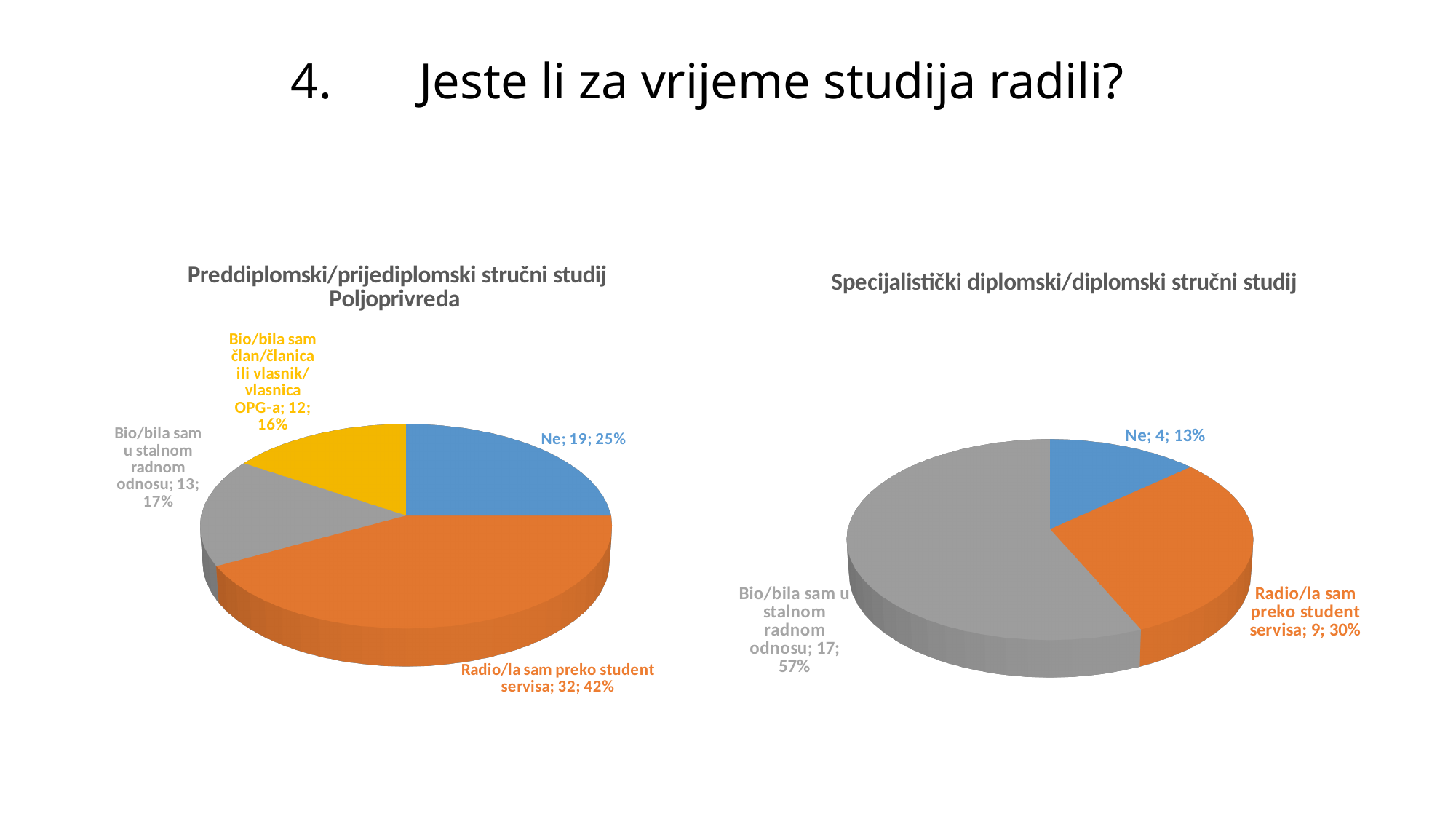
In the right chart (Specijalistički diplomski/diplomski stručni studij), which category has the largest slice? Bio/bila sam u stalnom radnom odnosu In the left chart (Preddiplomski/prijediplomski stručni studij Poljoprivreda), how many respondents answered "Ne"? 19 What kind of chart is shown on the left of the slide? Pie chart In the left chart (Preddiplomski/prijediplomski stručni studij Poljoprivreda), what is the difference between the counts for "Radio/la sam preko student servisa" and "Ne"? 13 In the left chart (Preddiplomski/prijediplomski stručni studij Poljoprivreda), what share of the pie is "Radio/la sam preko student servisa"? 42% In the left chart (Preddiplomski/prijediplomski stručni studij Poljoprivreda), which category has the smallest slice? Bio/bila sam član/članica ili vlasnik/vlasnica OPG-a In the left chart (Preddiplomski/prijediplomski stručni studij Poljoprivreda), how many slices does the pie have? 4 In the left chart (Preddiplomski/prijediplomski stručni studij Poljoprivreda), which category has the largest slice? Radio/la sam preko student servisa In the right chart (Specijalistički diplomski/diplomski stručni studij), which is larger: "Radio/la sam preko student servisa" or "Ne"? Radio/la sam preko student servisa In the right chart (Specijalistički diplomski/diplomski stručni studij), what share of the pie is "Ne"? 13% In the right chart (Specijalistički diplomski/diplomski stručni studij), how many respondents answered "Bio/bila sam u stalnom radnom odnosu"? 17 In the right chart (Specijalistički diplomski/diplomski stručni studij), how many slices does the pie have? 3